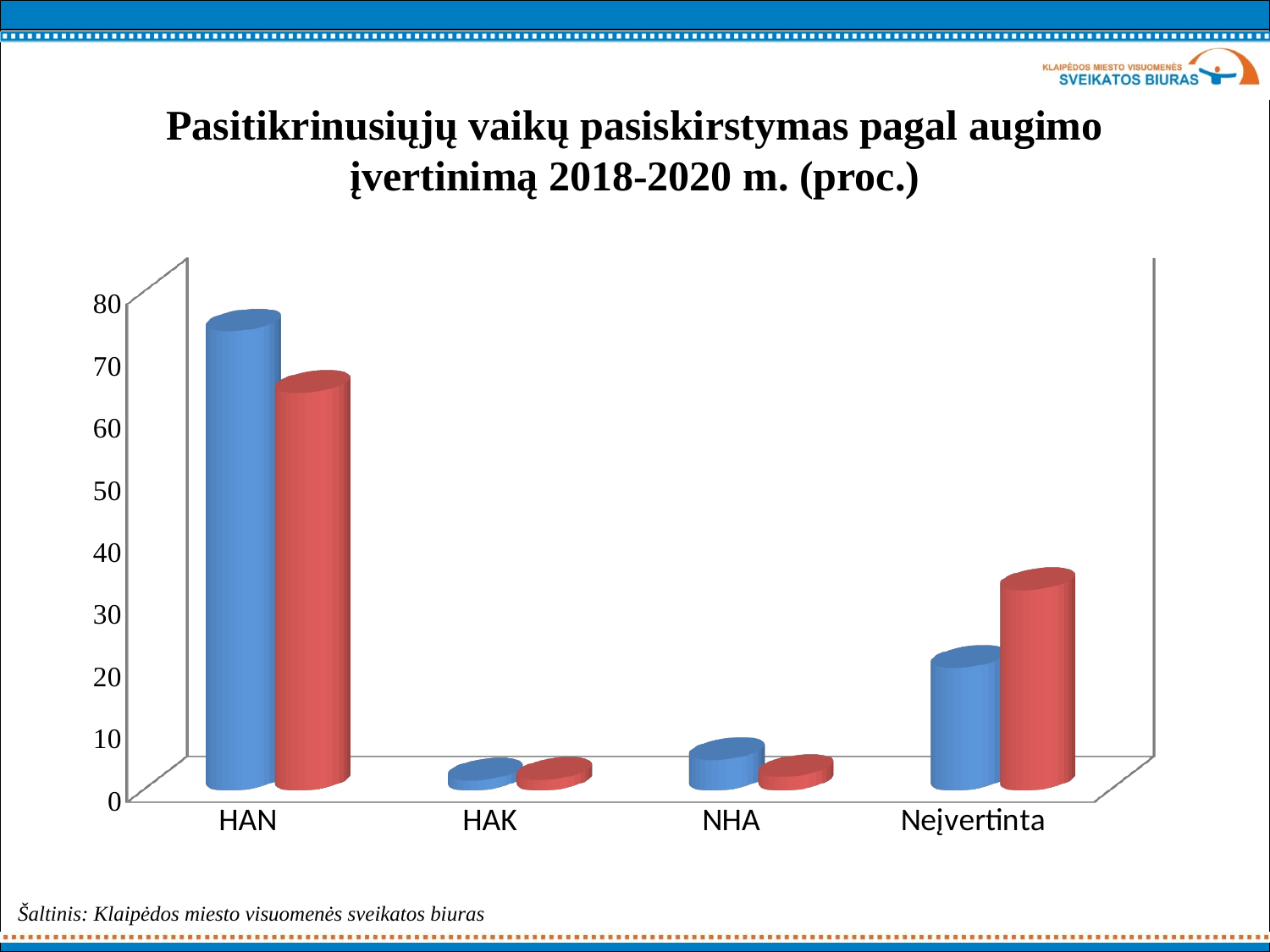
Which category has the tallest red bar? HAN Which category has the tallest blue bar? HAN How many categories are shown on the x axis of the chart? 4 What kind of chart is shown on the slide? bar chart What is the title of the chart on the slide? Pasitikrinusiųjų vaikų pasiskirstymas pagal augimo įvertinimą 2018-2020 m. (proc.) Is the value of the blue bar for Neįvertinta greater or less than 30? less Is the value of the blue bar for HAK greater or less than 10? less Is the value of the blue bar for HAN greater or less than 60? greater For the Neįvertinta category, which bar is taller, the blue one or the red one? the red one Which category has the shortest blue bar? HAK